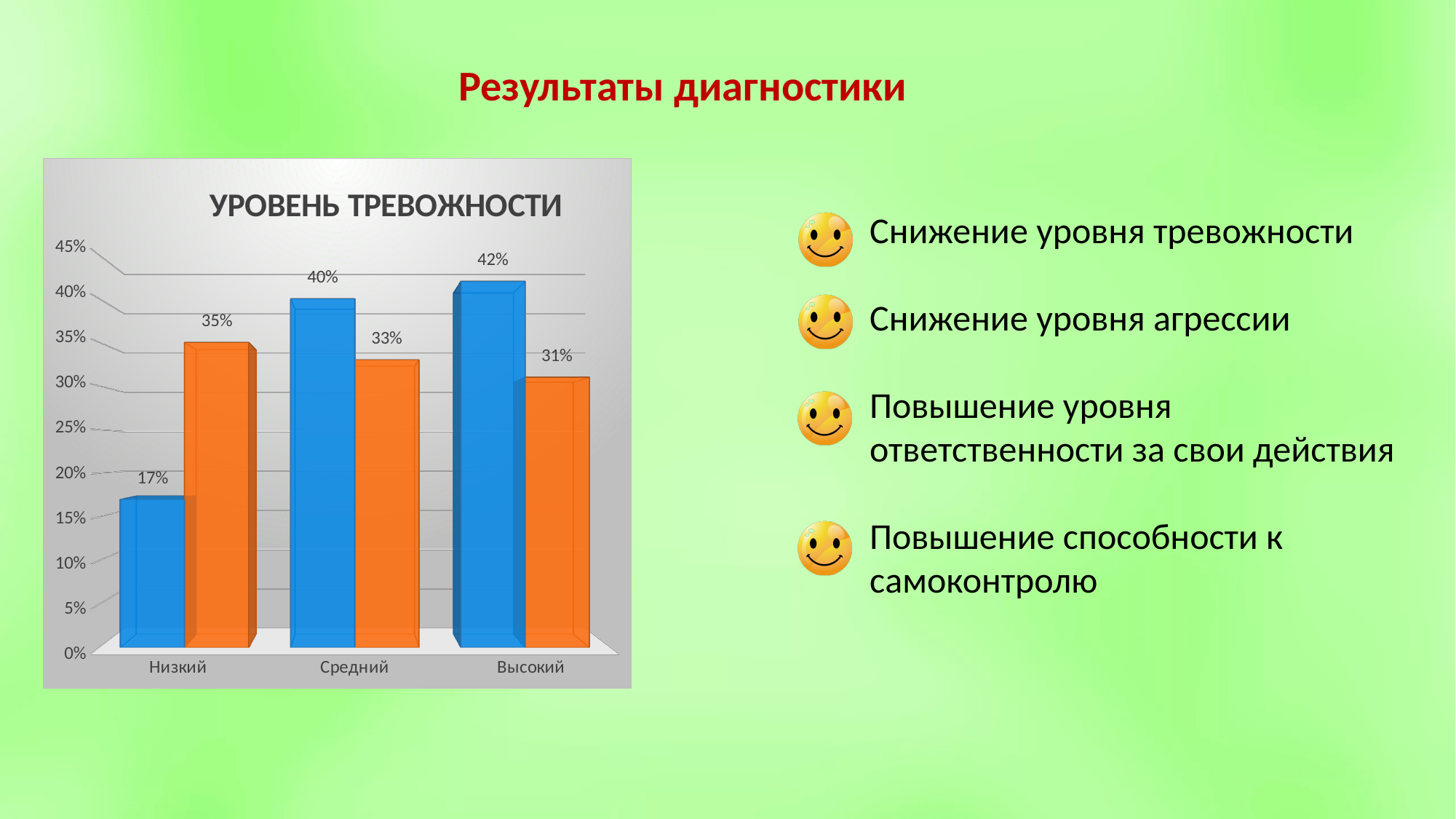
Which category has the lowest blue bar? Низкий What is the value of the blue bar for Средний? 40% For Средний, which is larger: the blue bar or the orange bar? The blue bar (40%) Which category has the highest blue bar? Высокий Which category has the highest orange bar? Низкий What is the difference between the orange bar and the blue bar for Низкий? 18% What kind of chart is shown on the slide? Bar chart What is the value of the blue bar for Низкий? 17% What is the value of the orange bar for Низкий? 35% How many categories are shown on the x axis? 3 What is the value of the orange bar for Высокий? 31% Do the orange bars rise or fall from Низкий to Высокий? Fall